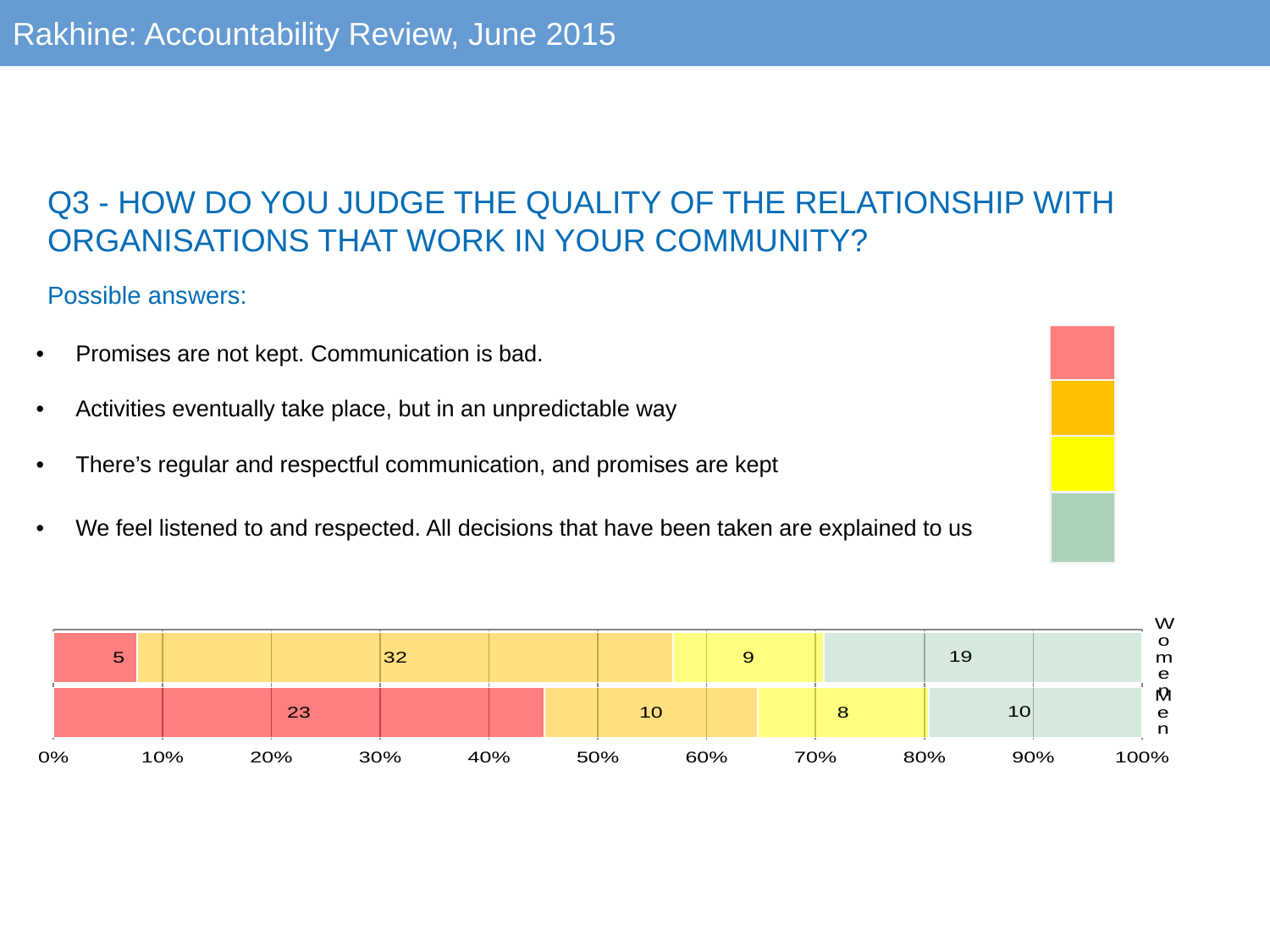
Which group has the larger value for the green segment (We feel listened to and respected), Women or Men? Women What is the value of the green segment (We feel listened to and respected) in the Men bar? 10 Which answer category has the largest value in the Women bar? Activities eventually take place, but in an unpredictable way (32) What is the difference between the Men and Women values for the red segment (Promises are not kept)? 18 How many bars (respondent groups) does the chart show? 2 How many answer categories (colours) does the legend show? 4 What kind of chart is shown at the bottom of the slide? Stacked bar chart What is the value of the orange segment (Activities eventually take place, but in an unpredictable way) in the Women bar? 32 What is the value of the red segment (Promises are not kept) in the Women bar? 5 What is the value of the red segment (Promises are not kept) in the Men bar? 23 What is the total of all segments in the Women bar? 65 What is the total of all segments in the Men bar? 51